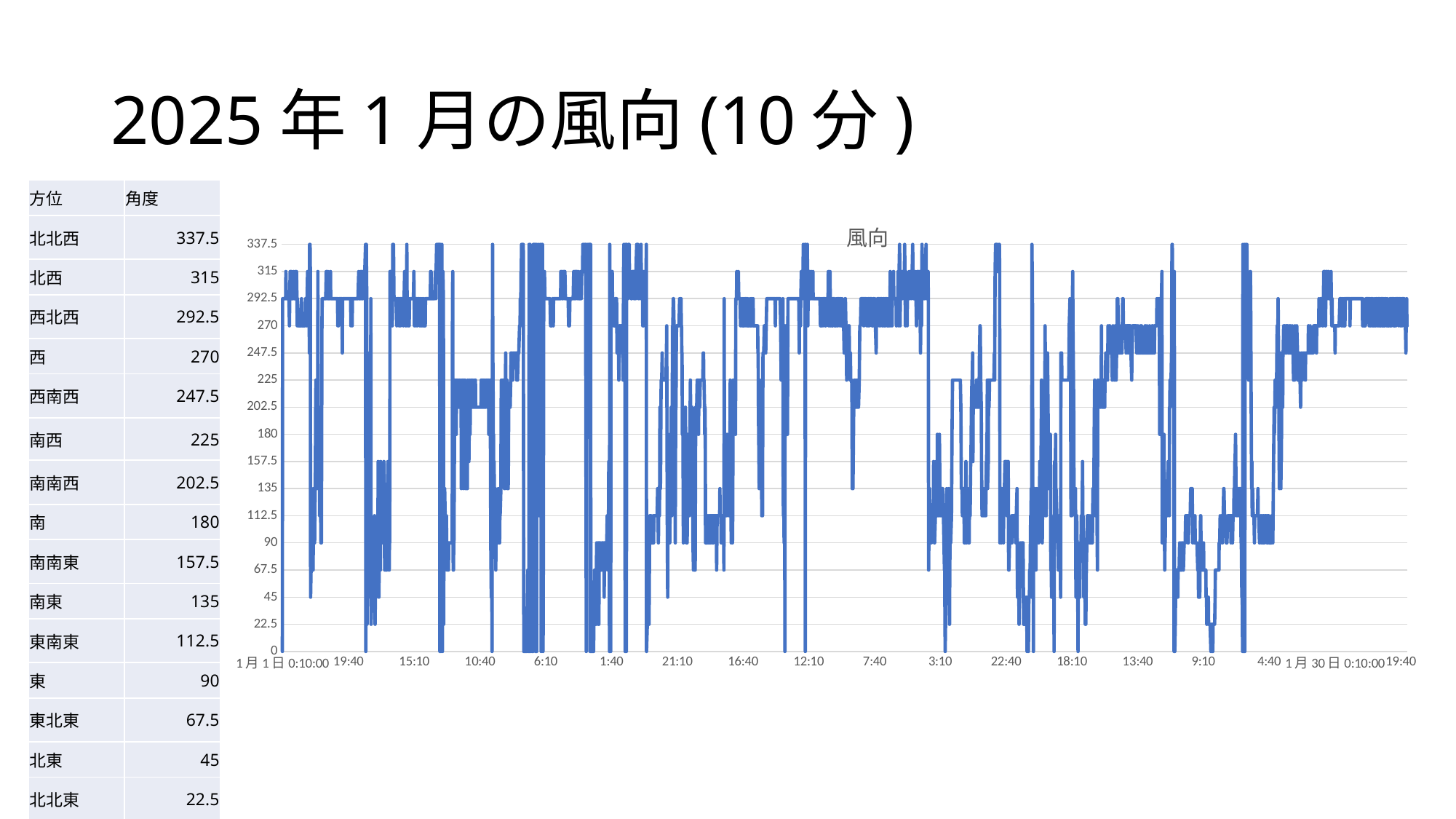
What is the lowest value the line reaches in the chart? 0 What is the title of the chart? 風向 Is the value at the very end of the line (at the right edge of the chart) greater or less than 180? greater What colour is the line in the chart? blue What is the highest value the line reaches in the chart? 337.5 What kind of chart is shown on the slide? line chart